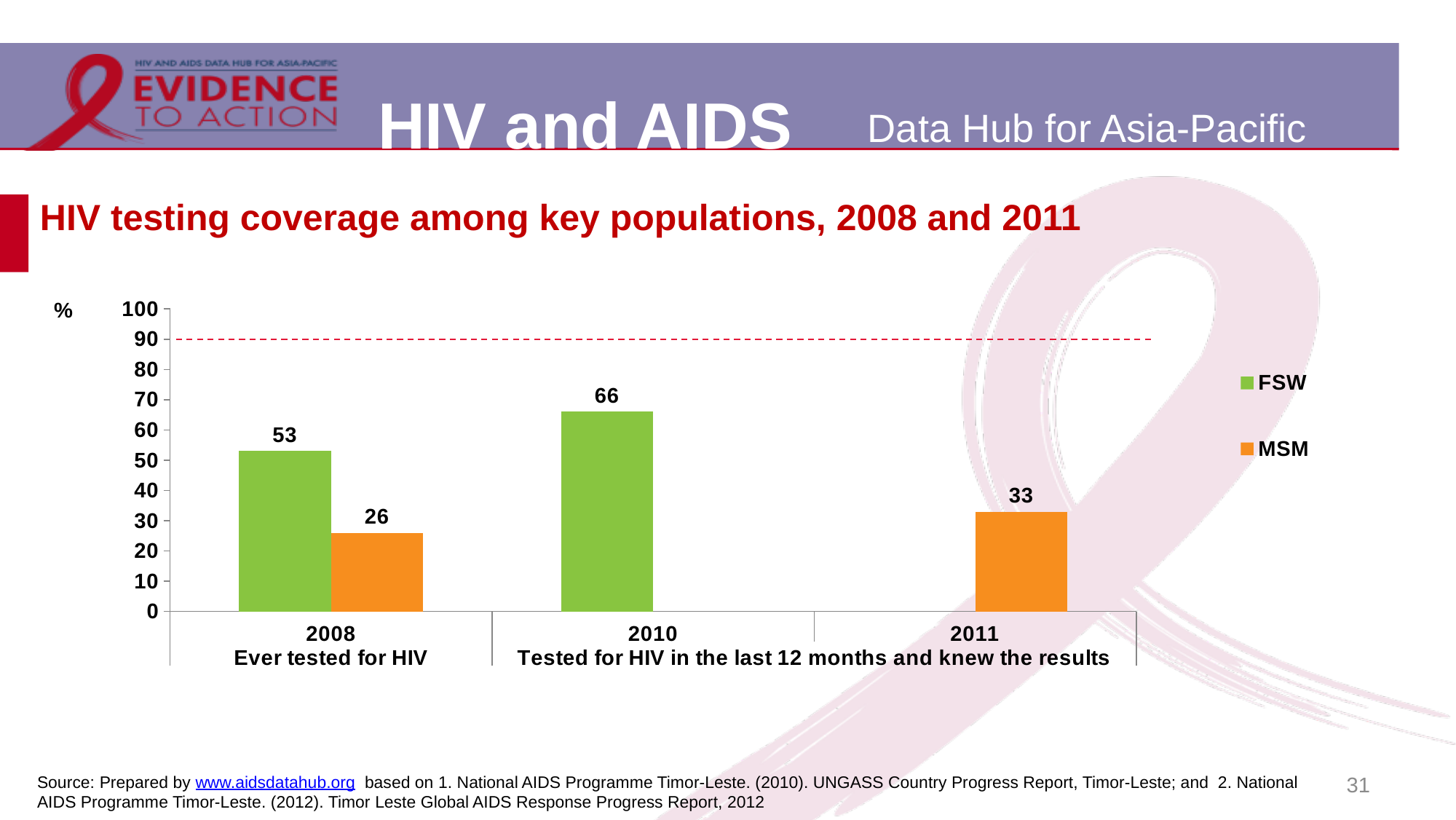
Which bar has the lowest value on the chart? MSM in 2008 Is the value for FSW in 2010 greater or less than 60? greater What is the value for FSW in 2010 (Tested for HIV in the last 12 months and knew the results)? 66 What is the difference between the FSW and MSM values in 2008? 27 What is the value for MSM in 2011 (Tested for HIV in the last 12 months and knew the results)? 33 What kind of chart is shown on the slide? Bar chart What is the value for MSM in 2008 (Ever tested for HIV)? 26 What colour represents MSM in the chart? Orange What is the value for FSW in 2008 (Ever tested for HIV)? 53 Which is larger: the FSW value in 2010 or the MSM value in 2011? FSW value in 2010 How many series does the legend list? 2 Which bar has the highest value on the chart? FSW in 2010